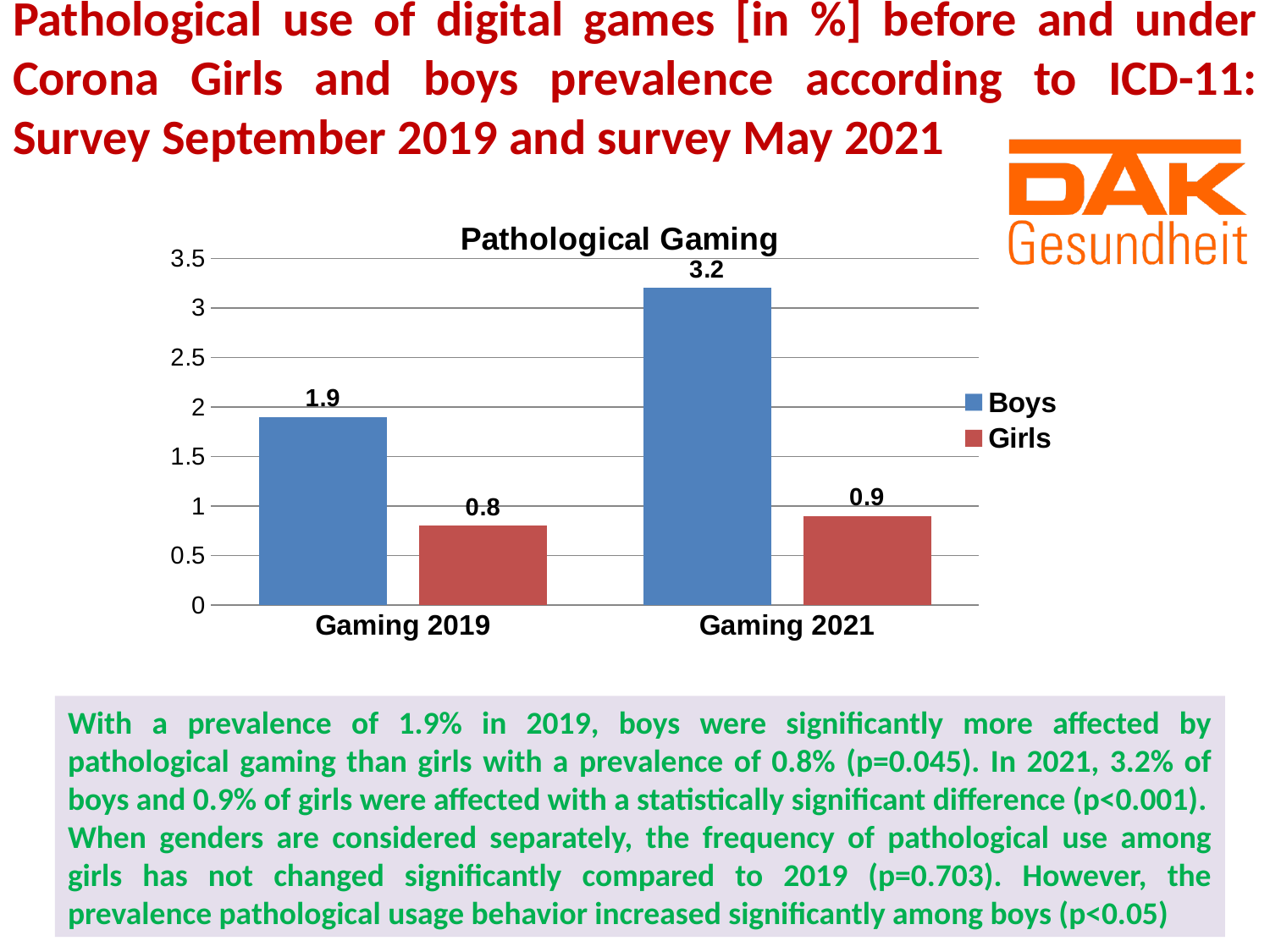
Which bar has the lowest value in the chart? Girls, Gaming 2019 What is the value for Boys in Gaming 2019? 1.9 What is the value for Girls in Gaming 2021? 0.9 Which is larger, Boys in Gaming 2019 or Boys in Gaming 2021? Boys in Gaming 2021 Is the value for Boys in Gaming 2021 greater or less than 3? greater How many categories are shown on the x axis? 2 What kind of chart is shown? bar chart What is the difference between Boys and Girls in Gaming 2021? 2.3 How many series does the legend list? 2 What is the difference between the Boys values for Gaming 2021 and Gaming 2019? 1.3 Which series has the highest value in Gaming 2021? Boys What is the value for Girls in Gaming 2019? 0.8